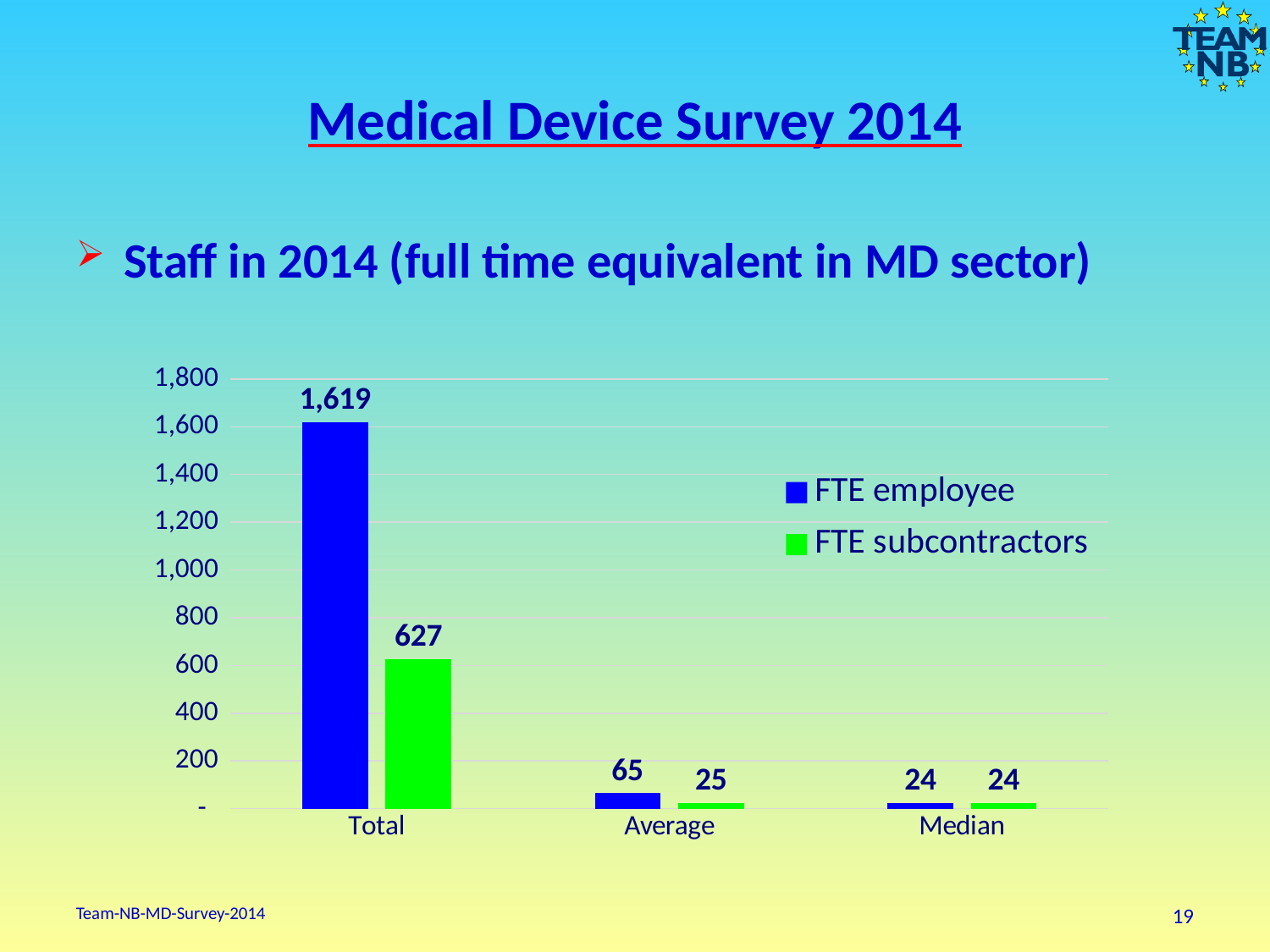
Is the FTE subcontractors value for Total greater or less than 800? less What is the FTE employee value for the Total category? 1,619 For the Average category, which is larger: FTE employee or FTE subcontractors? FTE employee What is the FTE subcontractors value for the Median category? 24 How many series does the legend list? 2 What is the FTE subcontractors value for the Total category? 627 What is the FTE employee value for the Average category? 65 What is the difference between the FTE employee and FTE subcontractors values for the Total category? 992 What kind of chart is shown on the slide? bar chart How many categories are shown on the x axis? 3 Which category has the highest FTE employee value? Total Which category has the lowest FTE subcontractors value? Median